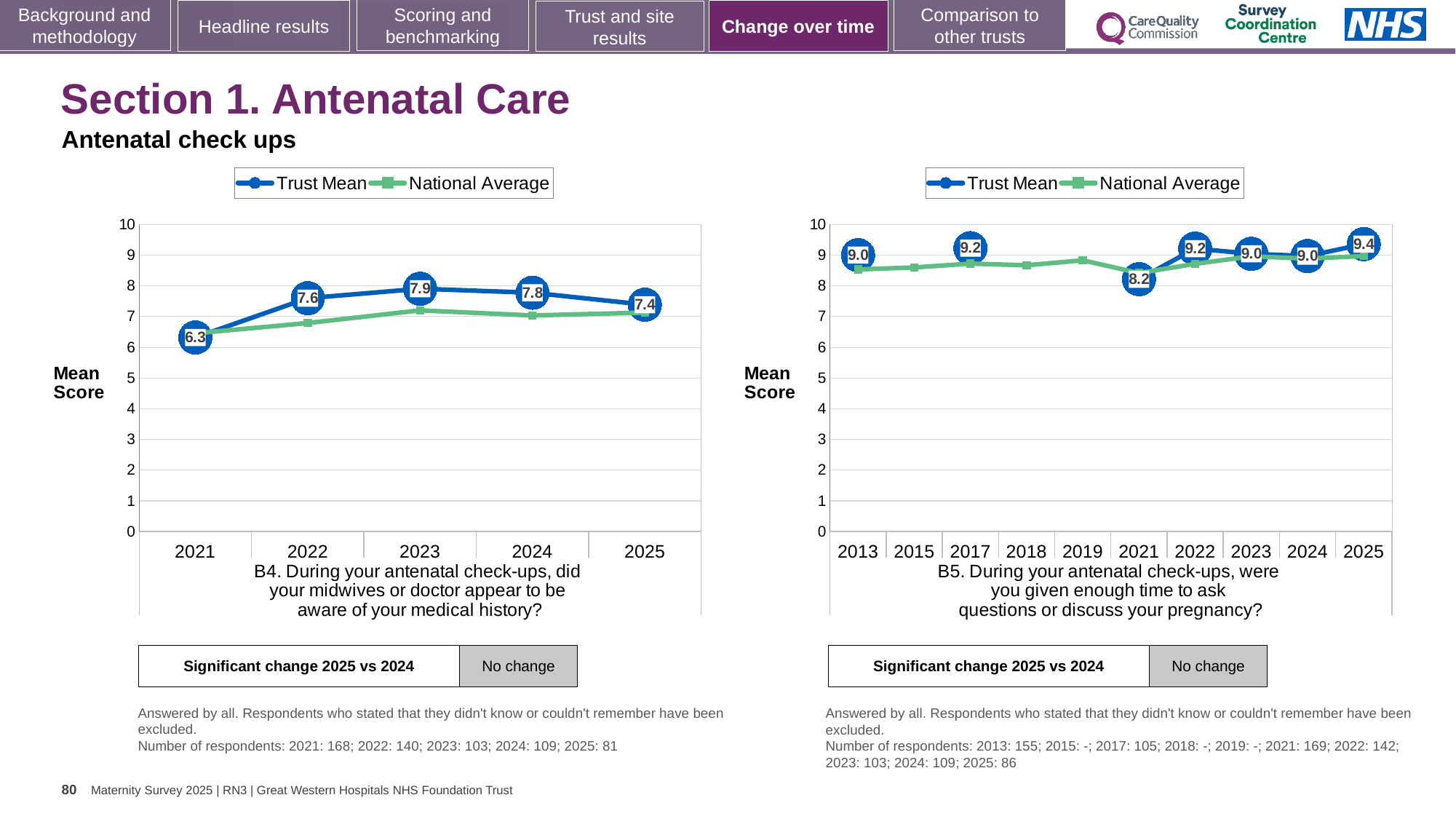
How many years are shown on the x axis of the B5 chart on the right? 10 In the B4 chart on the left, what is the difference between the Trust Mean scores for 2023 and 2021? 1.6 In the B4 chart on the left, what is the Trust Mean score for 2021? 6.3 How many series does the legend of the B4 chart on the left list? 2 In the B5 chart on the right, what is the Trust Mean score for 2025? 9.4 In the B5 chart on the right, what is the Trust Mean score for 2021? 8.2 In the B4 chart on the left, which year has the lowest Trust Mean score? 2021 In the B5 chart on the right, is the Trust Mean score for 2025 greater or less than the score for 2024? greater In the B4 chart on the left, which year has the highest Trust Mean score? 2023 In the B4 chart on the left, is the National Average for 2021 greater or less than 7? less In the B5 chart on the right, which year has the lowest Trust Mean score? 2021 In the B4 chart on the left, what is the Trust Mean score for 2025? 7.4